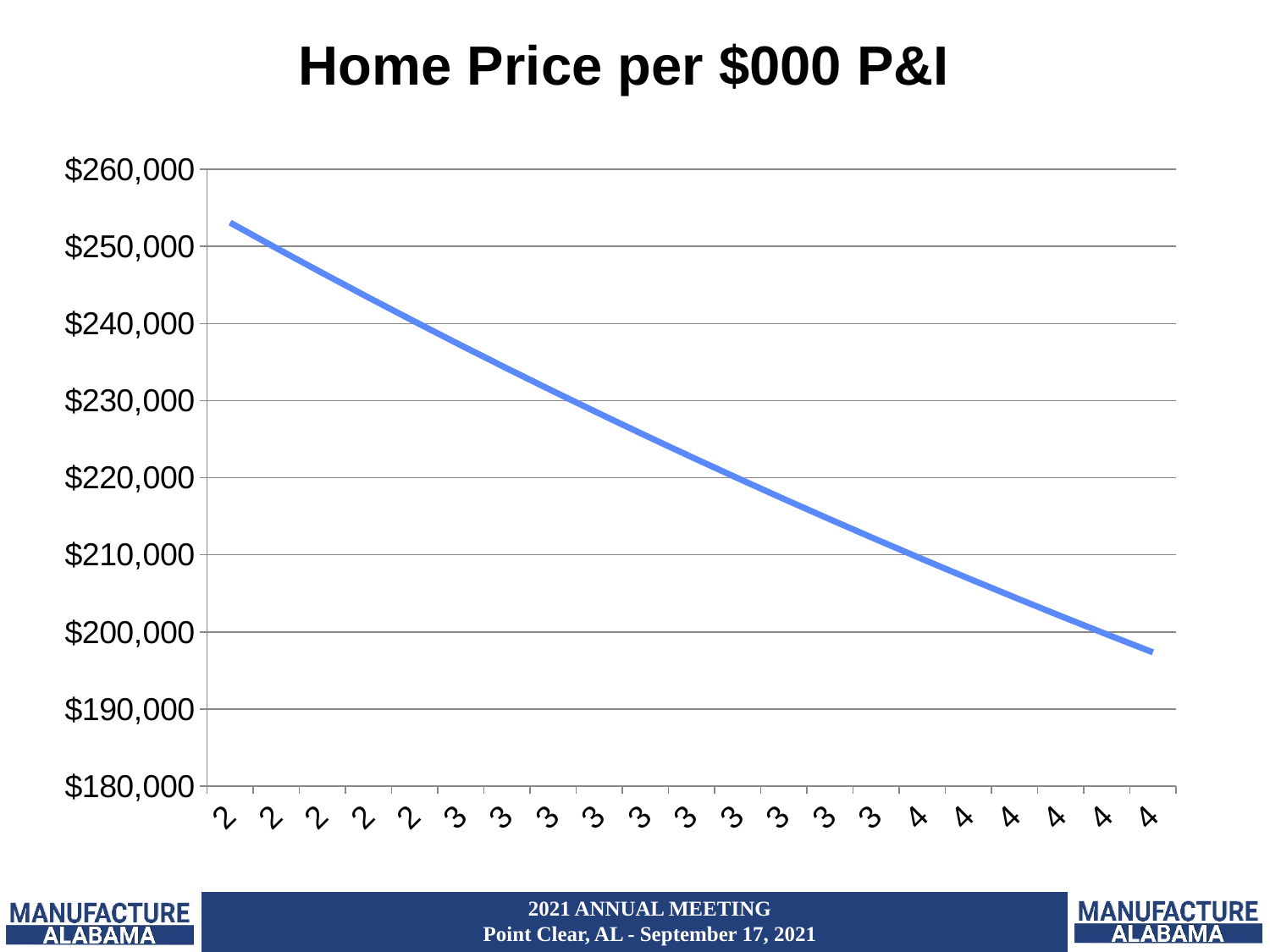
Is the value at the rightmost point of the line greater or less than $200,000? less Which end of the line, left or right, has the lowest value? Right Is the value at the leftmost point of the line greater or less than $260,000? less What is the lowest value shown on the y axis? $180,000 Is the value at the leftmost point of the line greater or less than $250,000? greater What is the title of the chart? Home Price per $000 P&I What is the highest value shown on the y axis? $260,000 Do the values rise or fall from left to right along the x axis? Fall Which end of the line, left or right, has the highest value? Left Is the value at the leftmost point larger or smaller than the value at the rightmost point? Larger What kind of chart is shown on the slide? Line chart